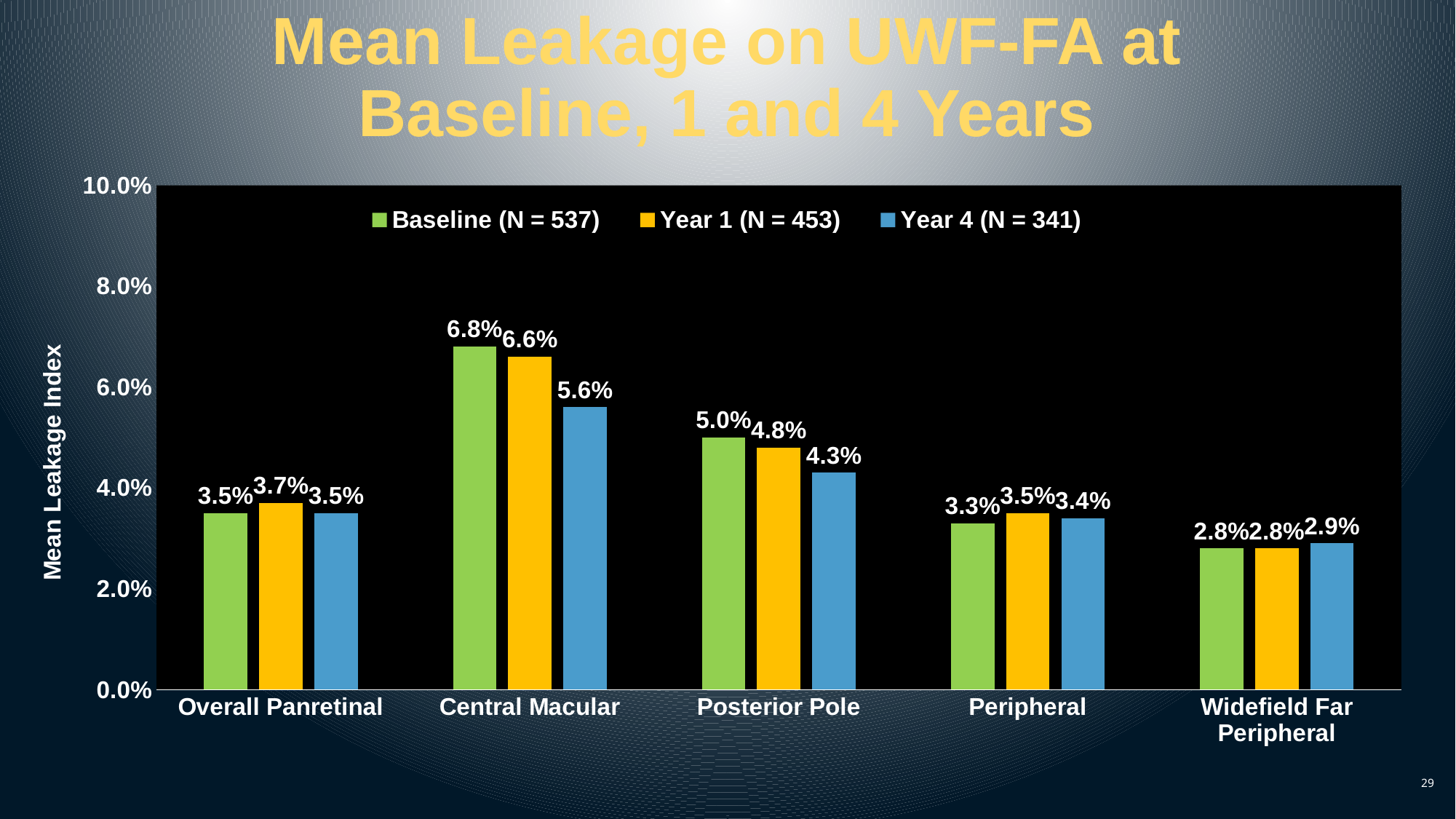
Is the Year 1 (N = 453) value for Central Macular greater or less than 6.0%? greater Which region has the lowest Year 4 (N = 341) mean leakage index? Widefield Far Peripheral How many series does the legend list? 3 What is the Year 1 (N = 453) mean leakage index for Overall Panretinal? 3.7% How many regions are shown on the x axis? 5 Is the Baseline (N = 537) value for Posterior Pole larger than the Year 4 (N = 341) value for Posterior Pole? Yes What is the Year 4 (N = 341) mean leakage index for Posterior Pole? 4.3% Which region has the highest Baseline (N = 537) mean leakage index? Central Macular What is the difference between the Baseline and Year 4 mean leakage index for Central Macular? 1.2% What is the Baseline (N = 537) mean leakage index for Central Macular? 6.8% What kind of chart is shown on the slide? Bar chart What is the label of the y axis? Mean Leakage Index